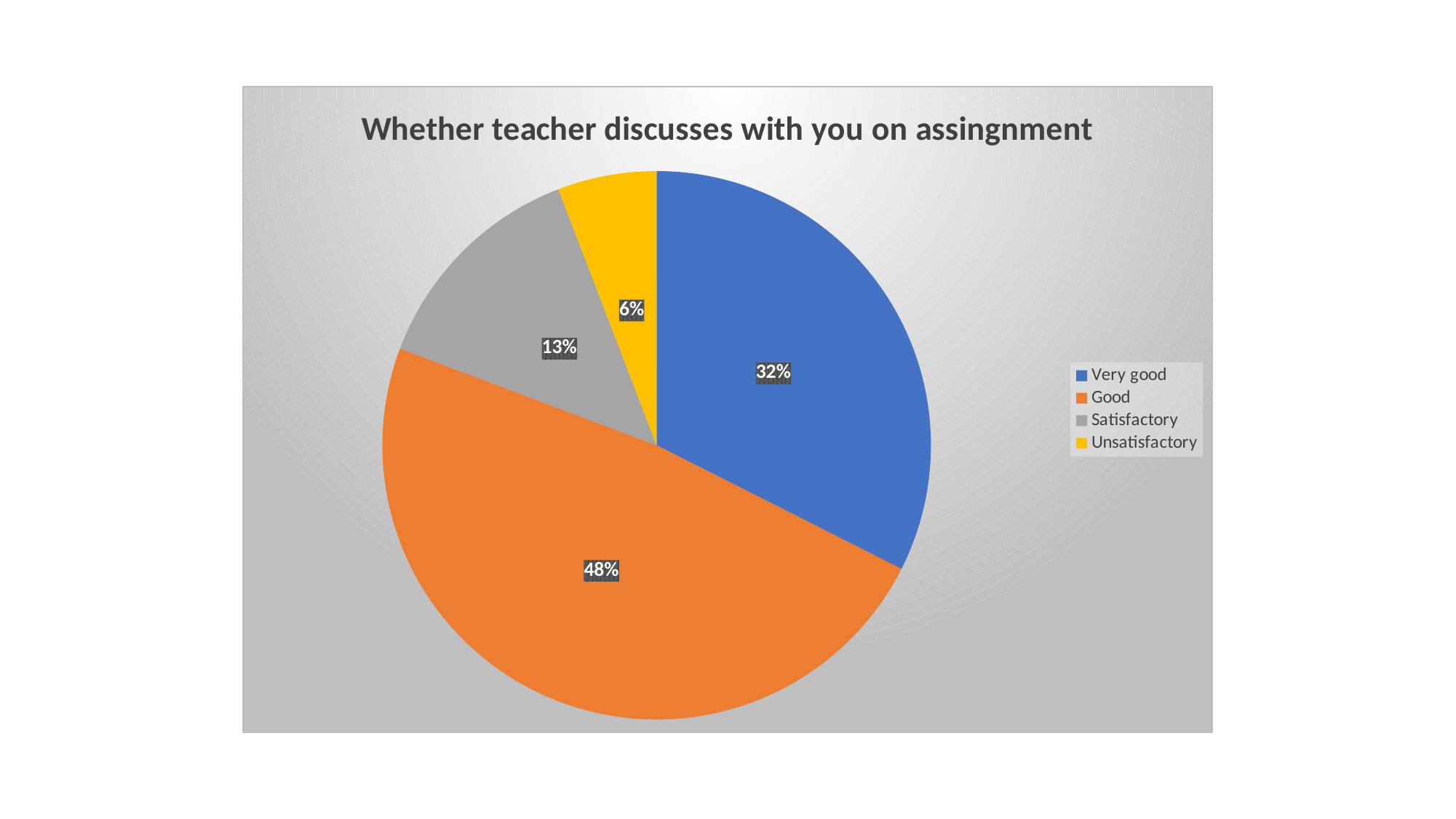
What colour is the slice for Unsatisfactory? yellow What kind of chart is shown on the slide? pie chart What percentage of the pie is labelled Satisfactory? 13% What percentage of the pie is labelled Unsatisfactory? 6% What is the title of the chart? Whether teacher discusses with you on assingnment What is the difference in percentage points between the Good and Very good slices? 16 What percentage of the pie is labelled Very good? 32% Which slice is larger, Satisfactory or Unsatisfactory? Satisfactory How many categories does the pie chart show? 4 What percentage of the pie is labelled Good? 48% Which category has the smallest slice of the pie? Unsatisfactory Which category has the largest slice of the pie? Good